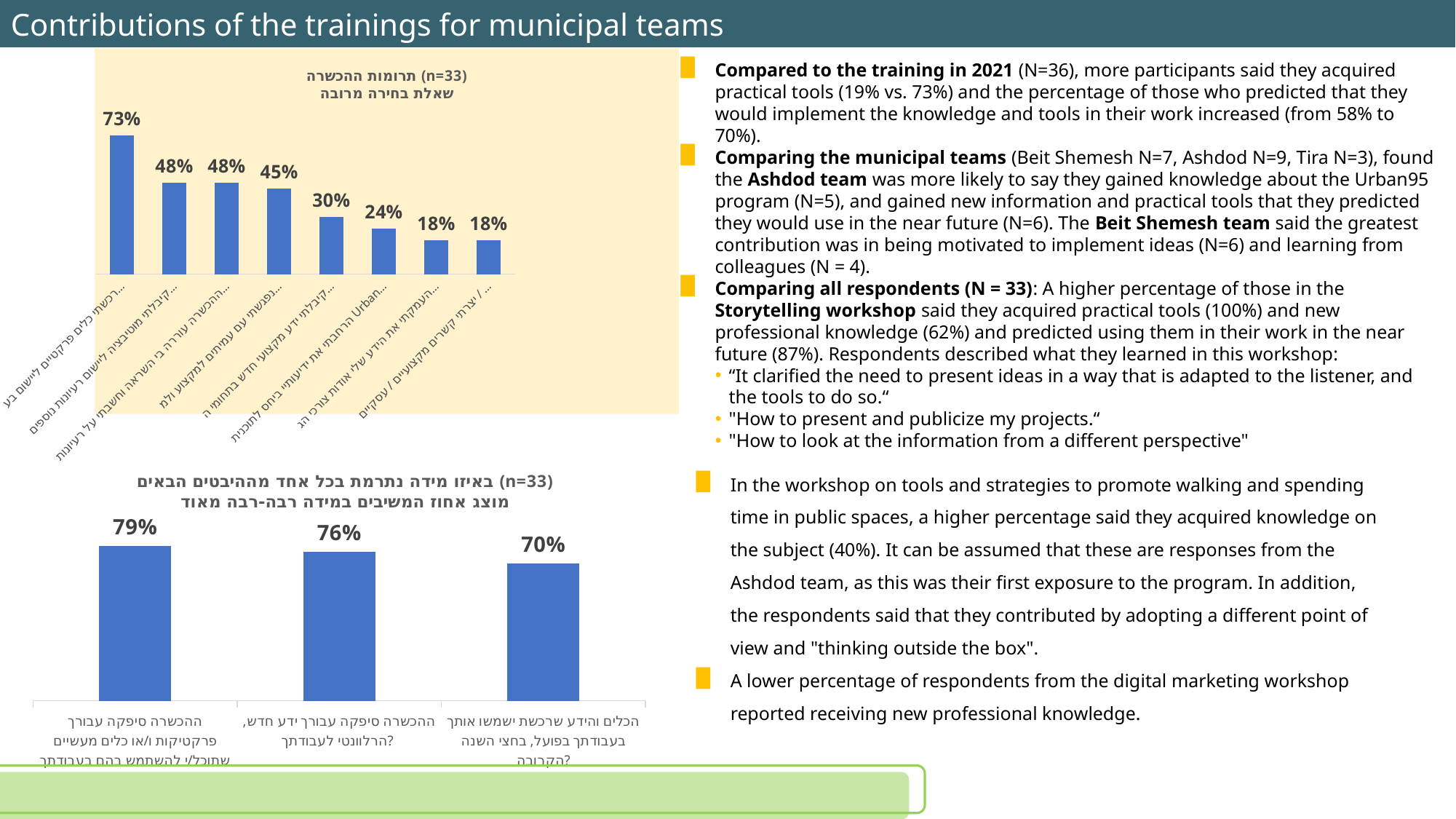
In the top chart, do the values rise or fall from left to right? fall How many categories are shown in the bottom chart? 3 In the bottom chart, what is the difference between the highest value (79%) and the lowest value (70%)? 9% In the top chart, what is the difference between the first bar (73%) and the fourth bar (45%)? 28% In the top chart, what is the value of the lowest bars? 18% What sample size (n) is stated in the title of the bottom chart? n=33 In the bottom chart, what is the value for 'הכלים והידע שרכשת ישמשו אותך בעבודתך בפועל, בחצי השנה הקרובה'? 70% In the bottom chart, what is the value for 'ההכשרה סיפקה עבורך ידע חדש, הרלוונטי לעבודתך'? 76% What type of chart is the top chart? bar chart How many bars are plotted in the top chart? 8 In the bottom chart, which category has the highest value? ההכשרה סיפקה עבורך פרקטיקות ו/או כלים מעשיים שתוכל/י להשתמש בהם בעבודתך In the top chart, what is the value of the tallest bar? 73%